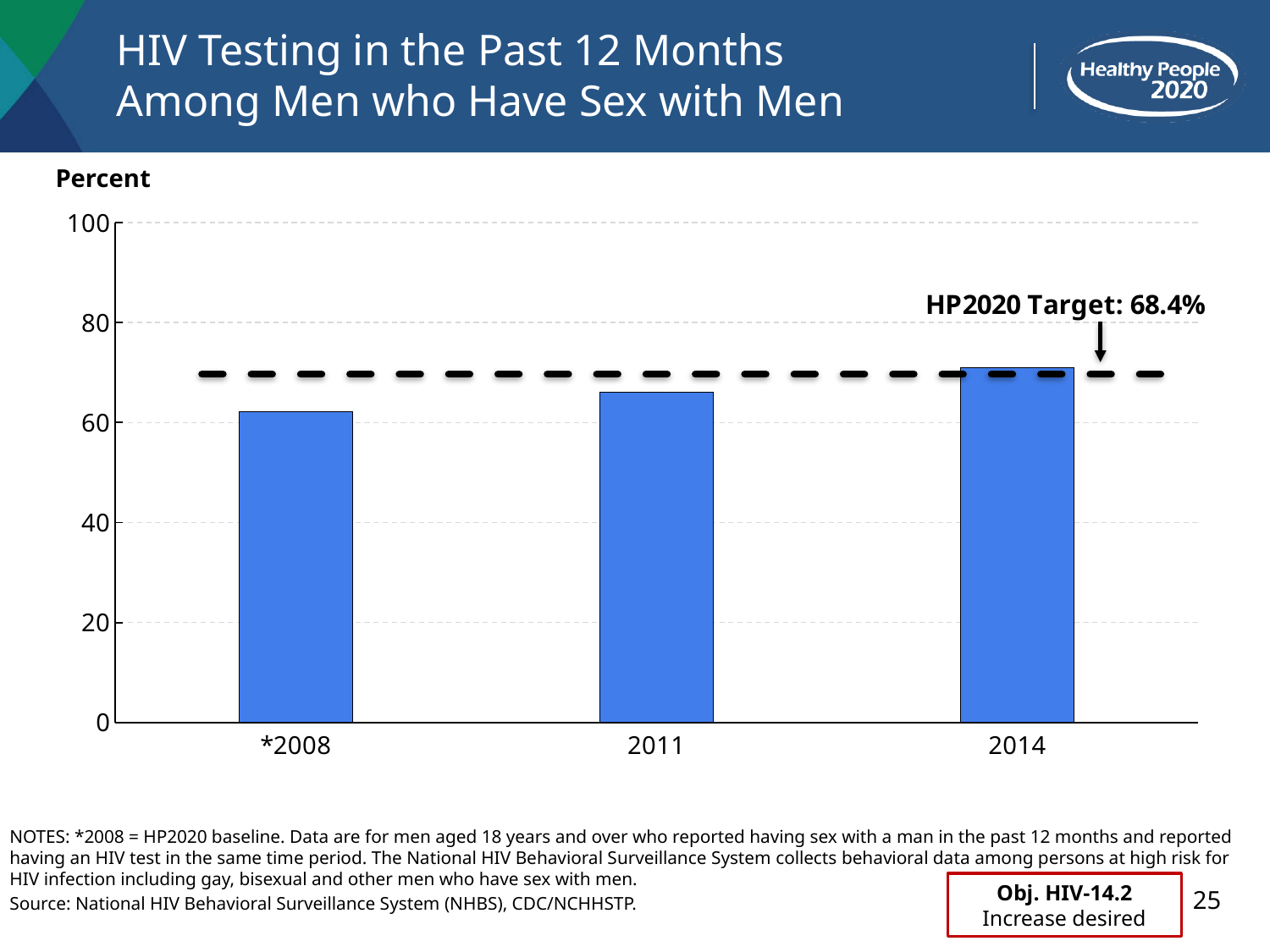
What is the HP2020 Target shown on the chart? 68.4% What is the label on the vertical axis of the chart? Percent Which year has the lowest percentage of HIV testing in the past 12 months? *2008 What kind of chart is shown on the slide? Bar chart Is the value for 2011 greater or less than 40? greater Do the values rise or fall from *2008 to 2014? Rise Is the value for 2014 greater or less than 60? greater How many years are plotted on the chart? 3 Which year has a higher value, *2008 or 2011? 2011 Which year has a higher value, 2011 or 2014? 2014 Which year has the highest percentage of HIV testing in the past 12 months? 2014 Is the value for *2008 greater or less than 80? less